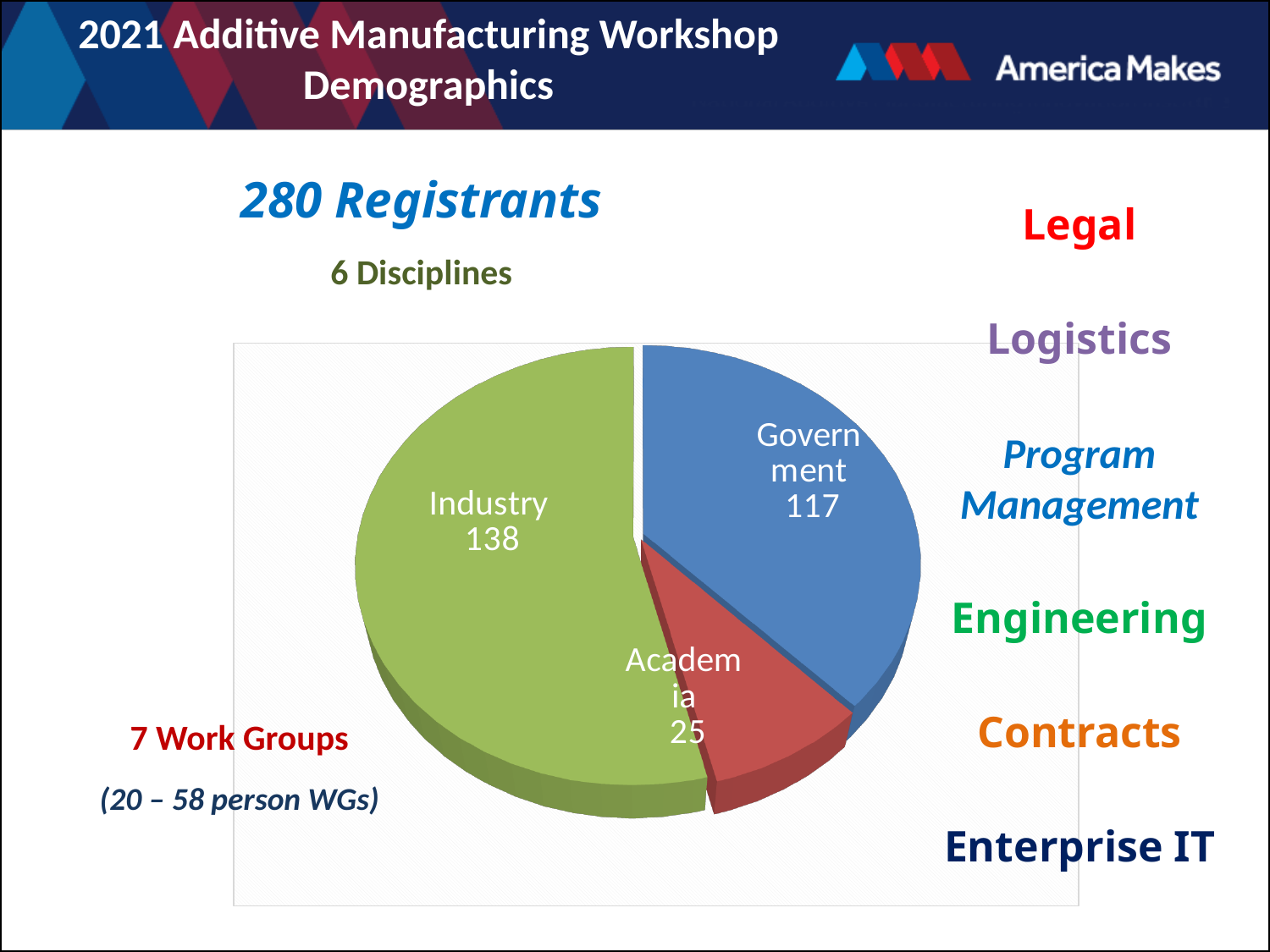
What is the difference between the Government and Academia values in the pie chart? 92 What is the value for Academia in the pie chart? 25 Which category has the largest slice in the pie chart? Industry How many slices does the pie chart have? 3 Which category has the smallest slice in the pie chart? Academia What colour is the Industry slice in the pie chart? Green What is the difference between the Industry and Government values in the pie chart? 21 Which is larger in the pie chart, Government or Academia? Government What is the total of all slices in the pie chart? 280 What type of chart is shown on the slide? Pie chart What is the value for Industry in the pie chart? 138 What is the value for Government in the pie chart? 117